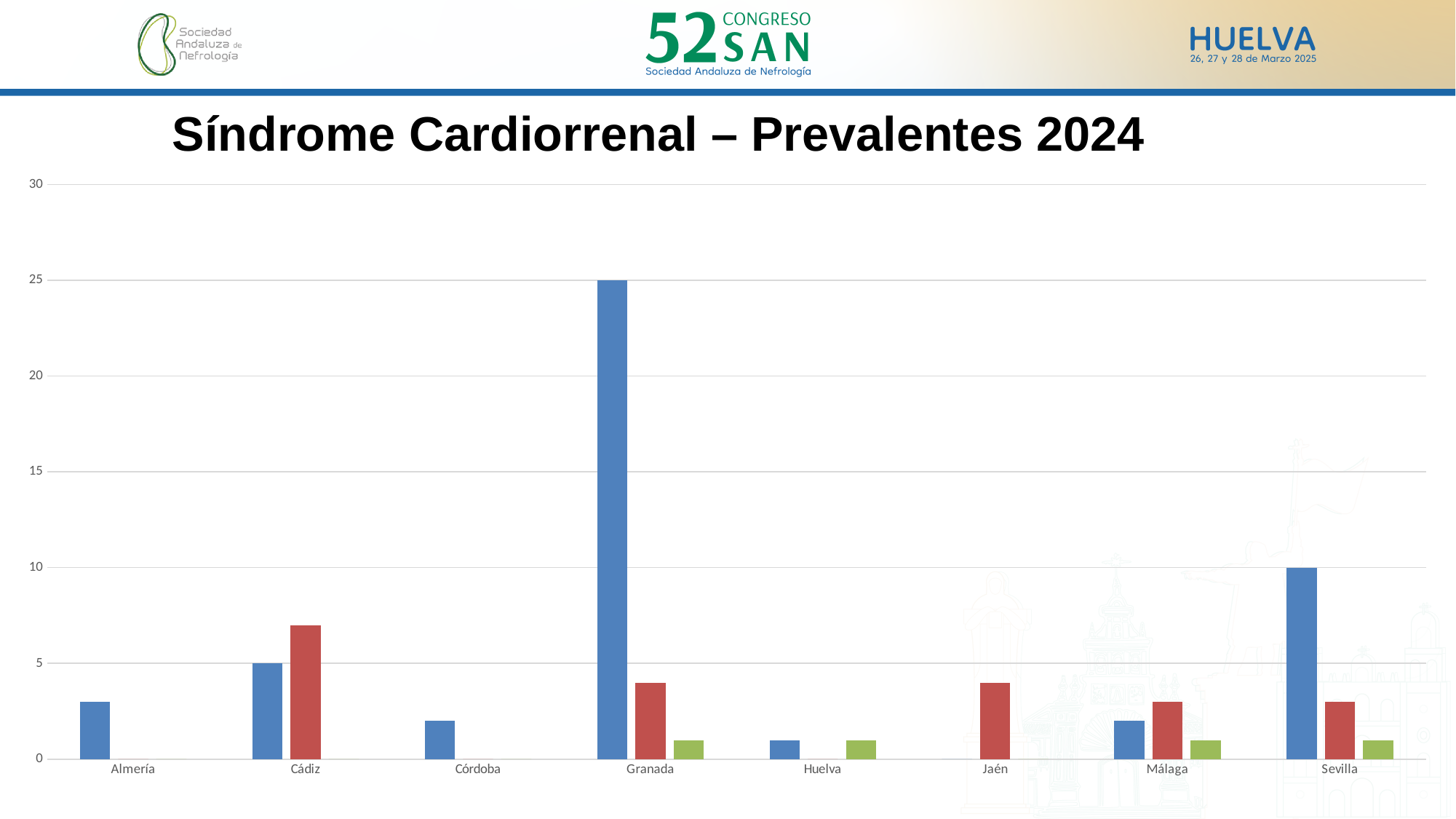
Is the value of the blue bar for Almería greater or less than 5? less What is the value of the blue bar for Granada? 25 What is the difference between the blue bar for Granada and the blue bar for Sevilla? 15 Is the value of the red bar for Cádiz greater or less than 5? greater How many provinces (categories) are shown on the x axis? 8 What is the value of the blue bar for Sevilla? 10 Which province has the tallest bar in the chart? Granada For Cádiz, which bar is taller, the blue bar or the red bar? the red bar What kind of chart is shown on the slide? bar chart What is the value of the blue bar for Cádiz? 5 Which is larger, the blue bar for Granada or the blue bar for Sevilla? Granada What is the title of the chart? Síndrome Cardiorrenal – Prevalentes 2024